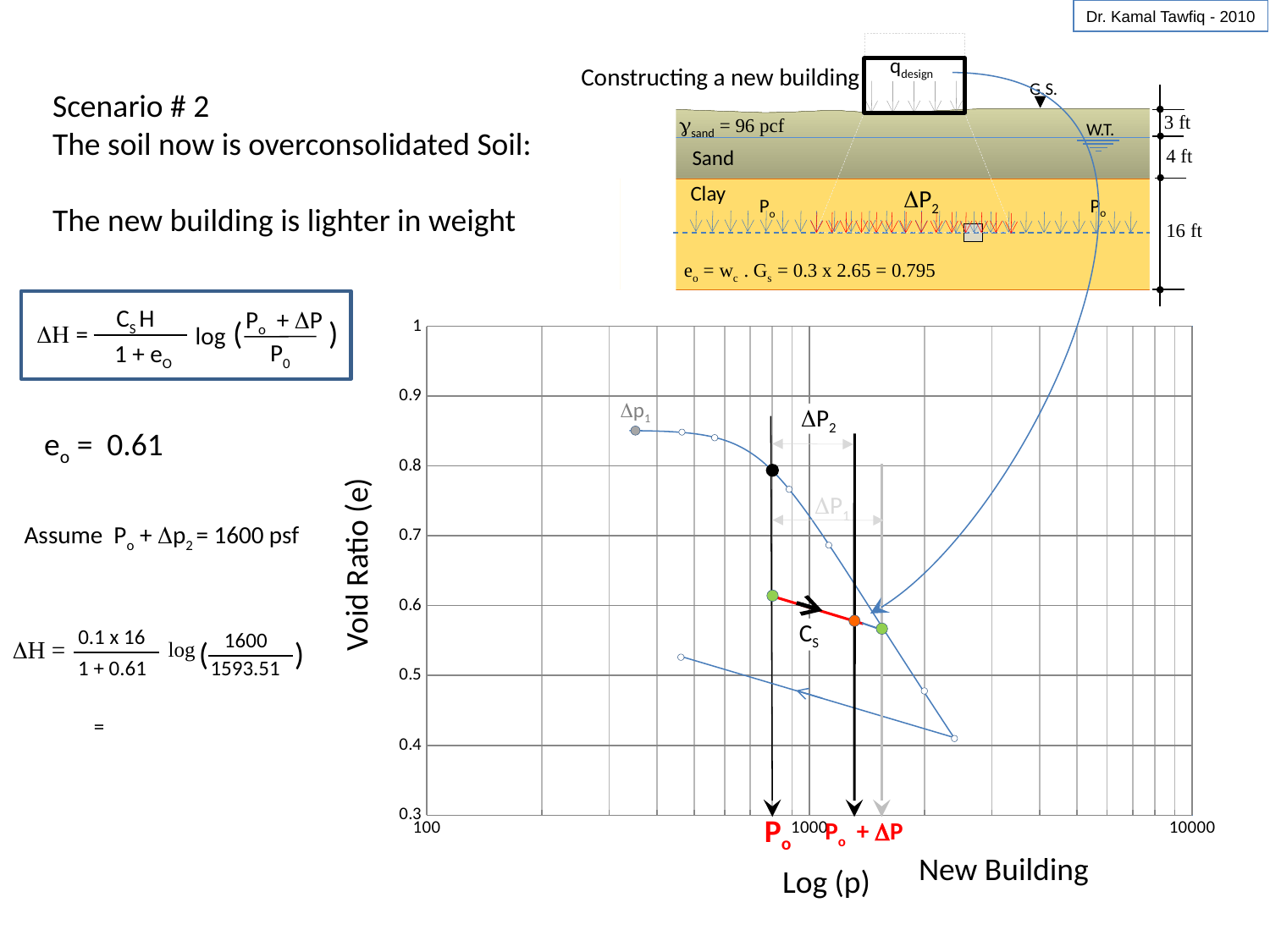
Is the void ratio of the green point at P_o greater or less than 0.7? less Along the main curve, does the void ratio rise or fall as p increases? fall Is the void ratio of the lowest point on the chart greater or less than 0.5? less Is the void ratio of the gray point labelled Δp1 greater or less than 0.8? greater Which has the higher void ratio: the gray point labelled Δp1 or the lowest point on the chart? the gray point labelled Δp1 Which has the higher void ratio: the black point at P_o or the orange point on the C_s line? the black point at P_o What kind of chart is shown on the slide? line chart What is the label of the vertical axis of the chart? Void Ratio (e) What is the label of the horizontal axis of the chart? Log (p) What is the lowest value shown on the vertical axis of the chart? 0.3